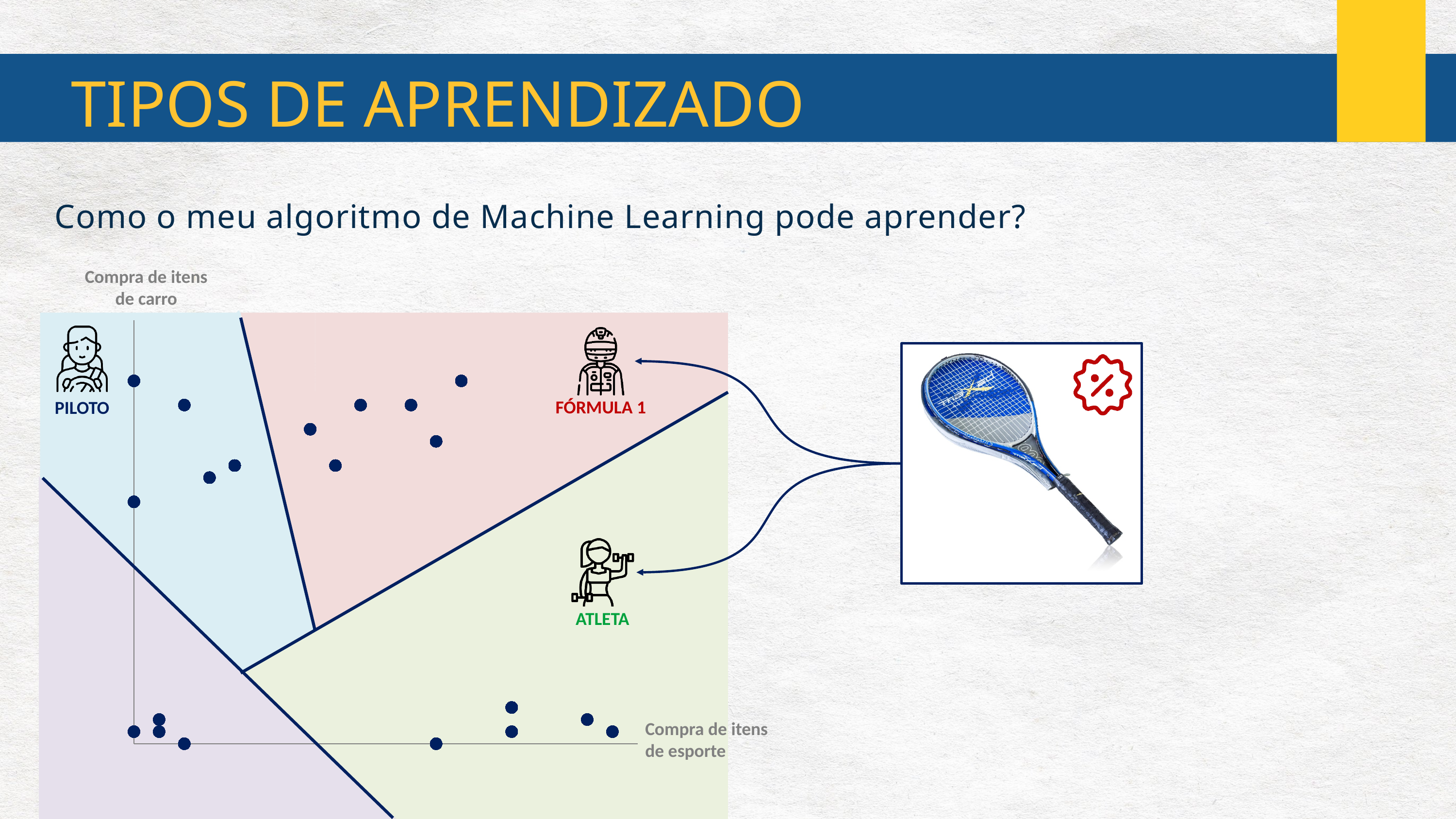
Which labeled group occupies the upper-right region of the chart, with high values on both axes? FÓRMULA 1 What kind of chart is shown on the slide? Scatter chart How many labeled groups (regions) are shown on the chart? 3 Which labeled group has points with high sport-item purchases but low car-item purchases? ATLETA What is the label of the vertical axis of the chart? Compra de itens de carro Which group's points are higher on the 'Compra de itens de carro' axis, PILOTO or ATLETA? PILOTO Which labeled group has points with high car-item purchases but low sport-item purchases? PILOTO Which group's points are lower on the 'Compra de itens de carro' axis, ATLETA or FÓRMULA 1? ATLETA Which group's points are further along the 'Compra de itens de esporte' axis, FÓRMULA 1 or PILOTO? FÓRMULA 1 What is the label of the horizontal axis of the chart? Compra de itens de esporte